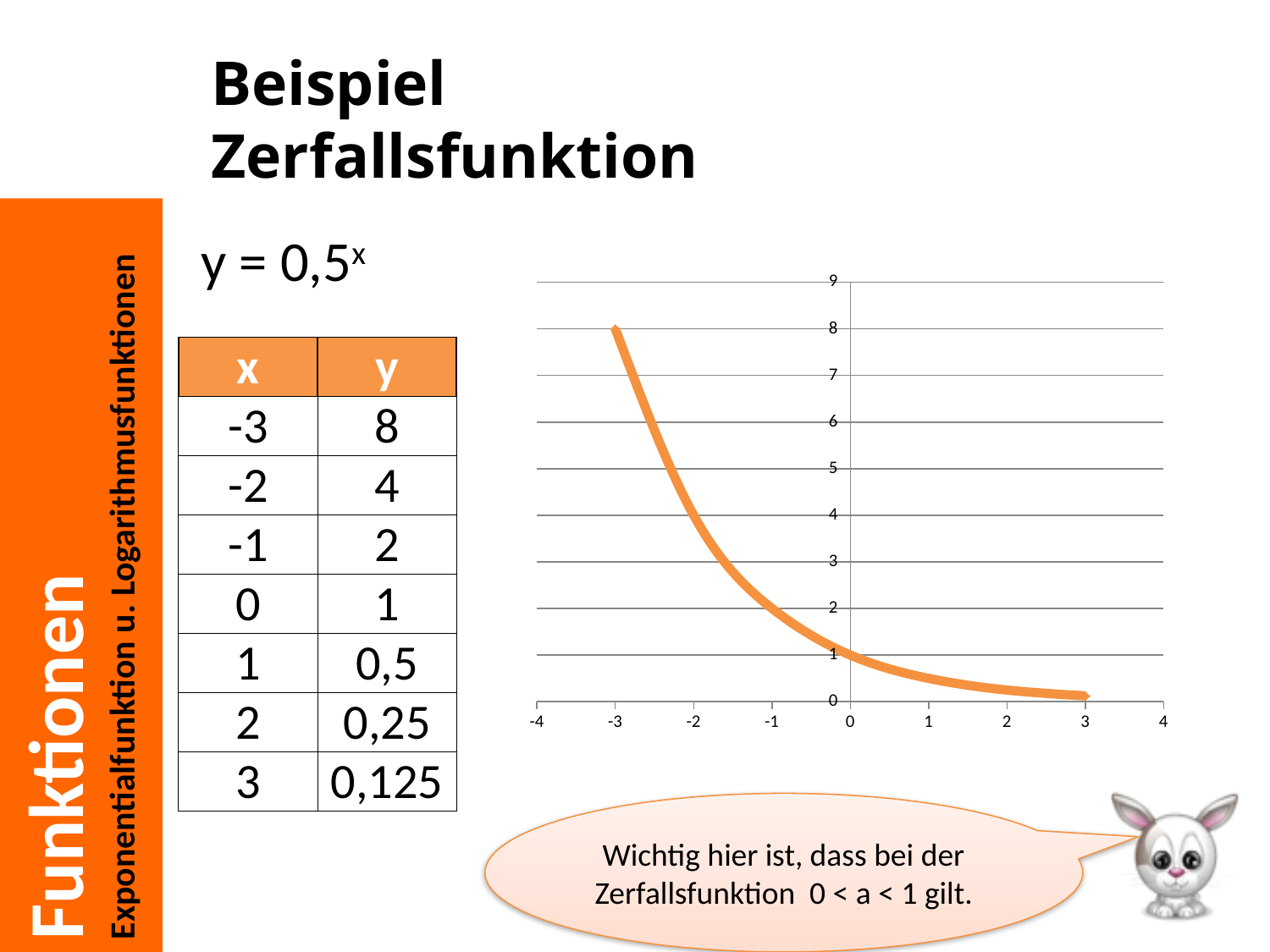
What is the value of y at x = 0 on the chart? 1 Which is larger, the y value at x = -2 or at x = 1? x = -2 What is the value of y at x = 3 according to the table on the slide? 0,125 What kind of chart is shown on the slide? line chart What is the value of y at x = -3 on the chart? 8 What is the difference between the y values at x = -3 and x = -2? 4 Do the values on the chart rise or fall as x increases? fall At which x value is the plotted y value highest? -3 Is the y value at x = -2 greater or less than 3? greater At which x value is the plotted y value lowest? 3 What is the highest value shown on the vertical axis of the chart? 9 What is the value of y at x = -1 on the chart? 2